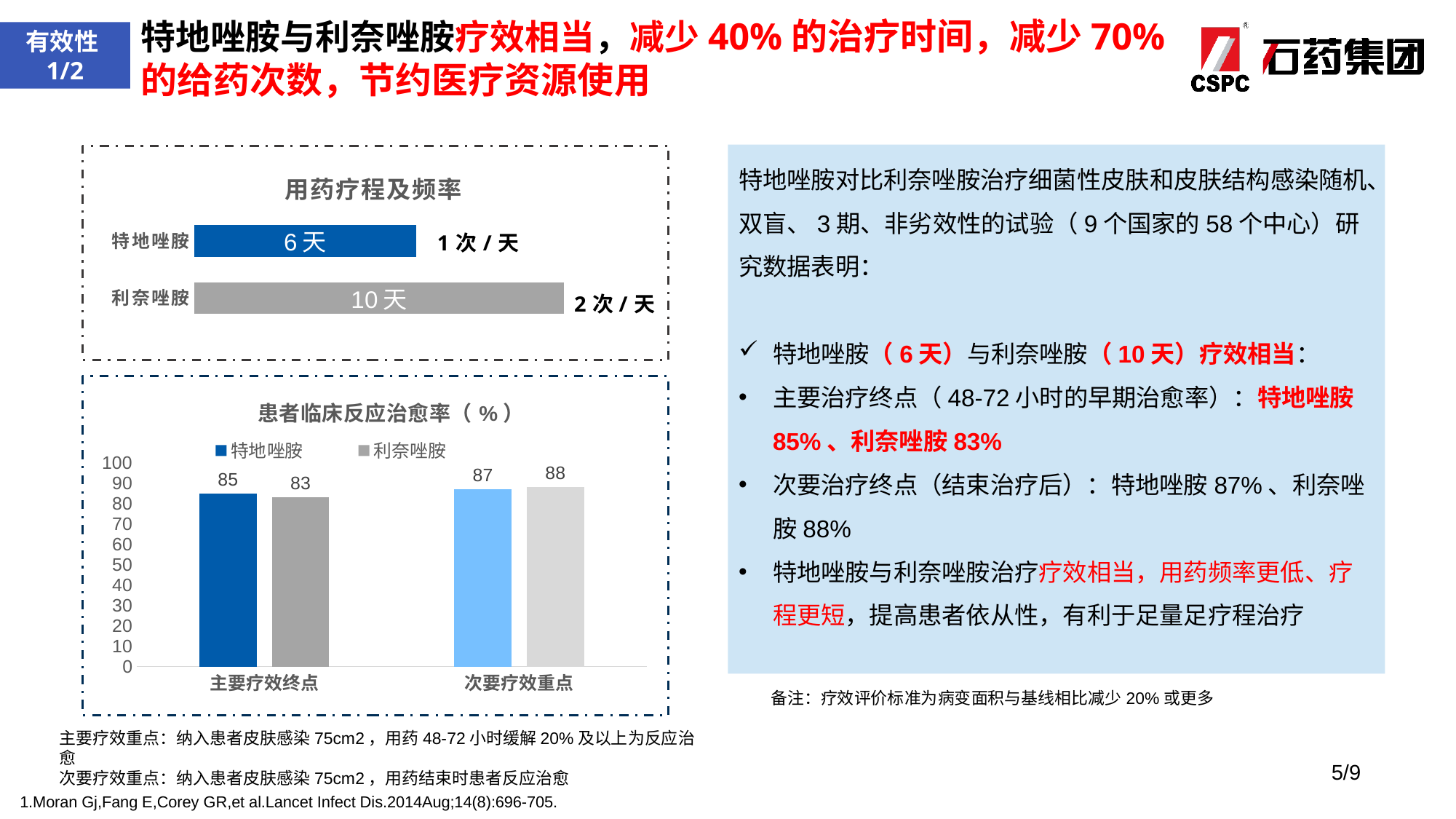
In the chart titled 患者临床反应治愈率（%）, what is the difference between 特地唑胺 and 利奈唑胺 at 主要疗效终点? 2 In the chart titled 用药疗程及频率, what is the treatment duration shown for 利奈唑胺? 10天 In the chart titled 用药疗程及频率, what dosing frequency is shown next to the 利奈唑胺 bar? 2次/天 In the chart titled 用药疗程及频率, what is the treatment duration shown for 特地唑胺? 6天 In the chart titled 患者临床反应治愈率（%）, what is the value for 利奈唑胺 at 次要疗效重点? 88 In the chart titled 患者临床反应治愈率（%）, which series has the higher value at 次要疗效重点? 利奈唑胺 In the chart titled 用药疗程及频率, which drug has the longer treatment course? 利奈唑胺 In the chart titled 用药疗程及频率, how many days longer is the 利奈唑胺 course than the 特地唑胺 course? 4天 What kind of chart is the one titled 患者临床反应治愈率（%）? bar chart In the chart titled 患者临床反应治愈率（%）, what is the value for 特地唑胺 at 主要疗效终点? 85 In the chart titled 患者临床反应治愈率（%）, how many series does the legend list? 2 In the chart titled 患者临床反应治愈率（%）, how many categories are shown on the x axis? 2